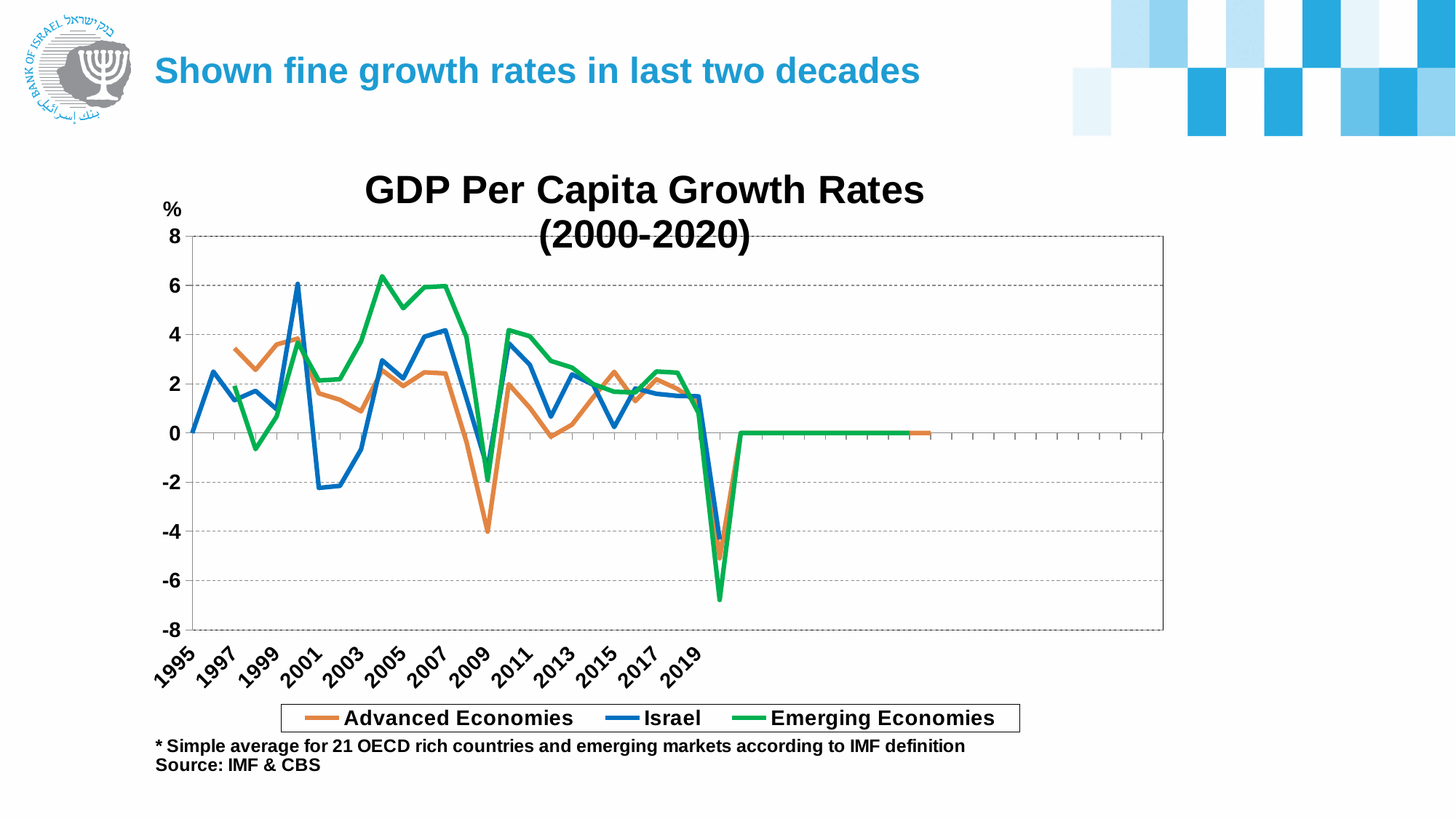
What kind of chart is shown on the slide? line chart Is the value for Emerging Economies in 2020 greater or less than -6? less Which series is drawn in green in the chart? Emerging Economies Is the value for Israel in 2000 greater or less than 4? greater In which year does the Emerging Economies series reach its lowest value? 2020 How many series does the legend of the GDP Per Capita Growth Rates chart list? 3 Which series has the highest value in 2004? Emerging Economies Is the value for Israel in 2002 greater or less than 0? less In 2000, which series has the higher value: Israel or Advanced Economies? Israel In 2020, which series has the lower value: Israel or Emerging Economies? Emerging Economies What is the title of the chart? GDP Per Capita Growth Rates (2000-2020)